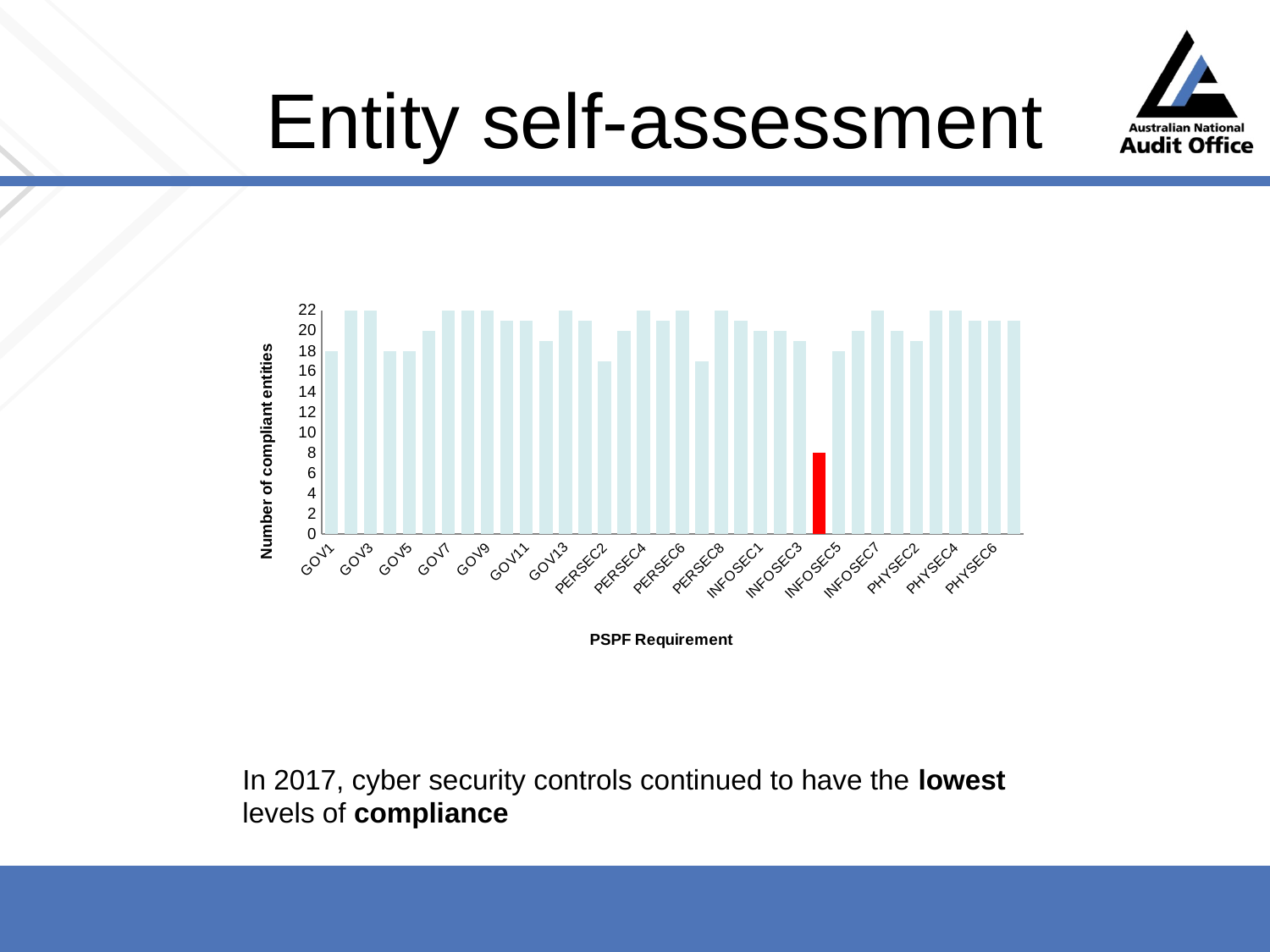
Which is larger, the value for GOV1 or the value of the red bar? GOV1 Is the value of the red bar greater or less than 10? less What is the value of the red bar in the chart? 8 Is the value for PERSEC2 greater or less than 20? less What is the title of the horizontal axis? PSPF Requirement Which bar in the chart is the lowest? the red bar Which is larger, the value for GOV1 or the value for GOV3? GOV3 What is the value for GOV1? 18 What is the highest value reached by any bar in the chart? 22 What is the title of the vertical axis? Number of compliant entities Is the value for GOV3 greater or less than 20? greater What kind of chart is shown on the slide? bar chart